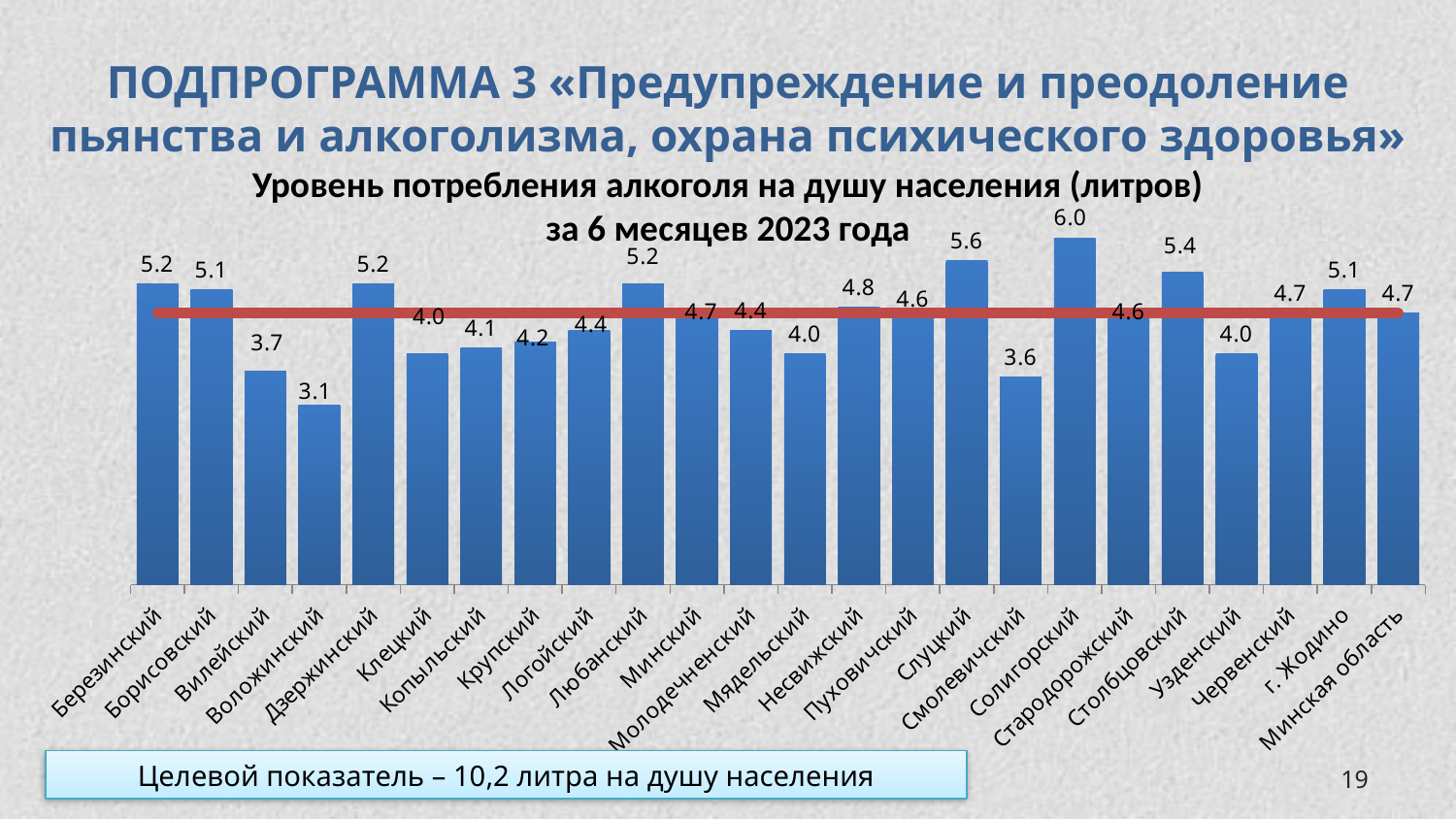
What type of chart is shown on the slide? bar chart Which district has the highest alcohol consumption per capita? Солигорский Which district has the lowest alcohol consumption per capita? Воложинский What is the difference between the values for Солигорский and Воложинский? 2.9 What is the alcohol consumption value for Солигорский? 6.0 What is the value shown for Смолевичский? 3.6 What is the title of the chart? Уровень потребления алкоголя на душу населения (литров) за 6 месяцев 2023 года Which has a higher value, Вилейский or Несвижский? Несвижский How many categories (districts and regions) are shown on the x axis? 24 What is the difference between the values for Слуцкий and Столбцовский? 0.2 What is the value shown for Воложинский? 3.1 What is the value shown for Минская область? 4.7